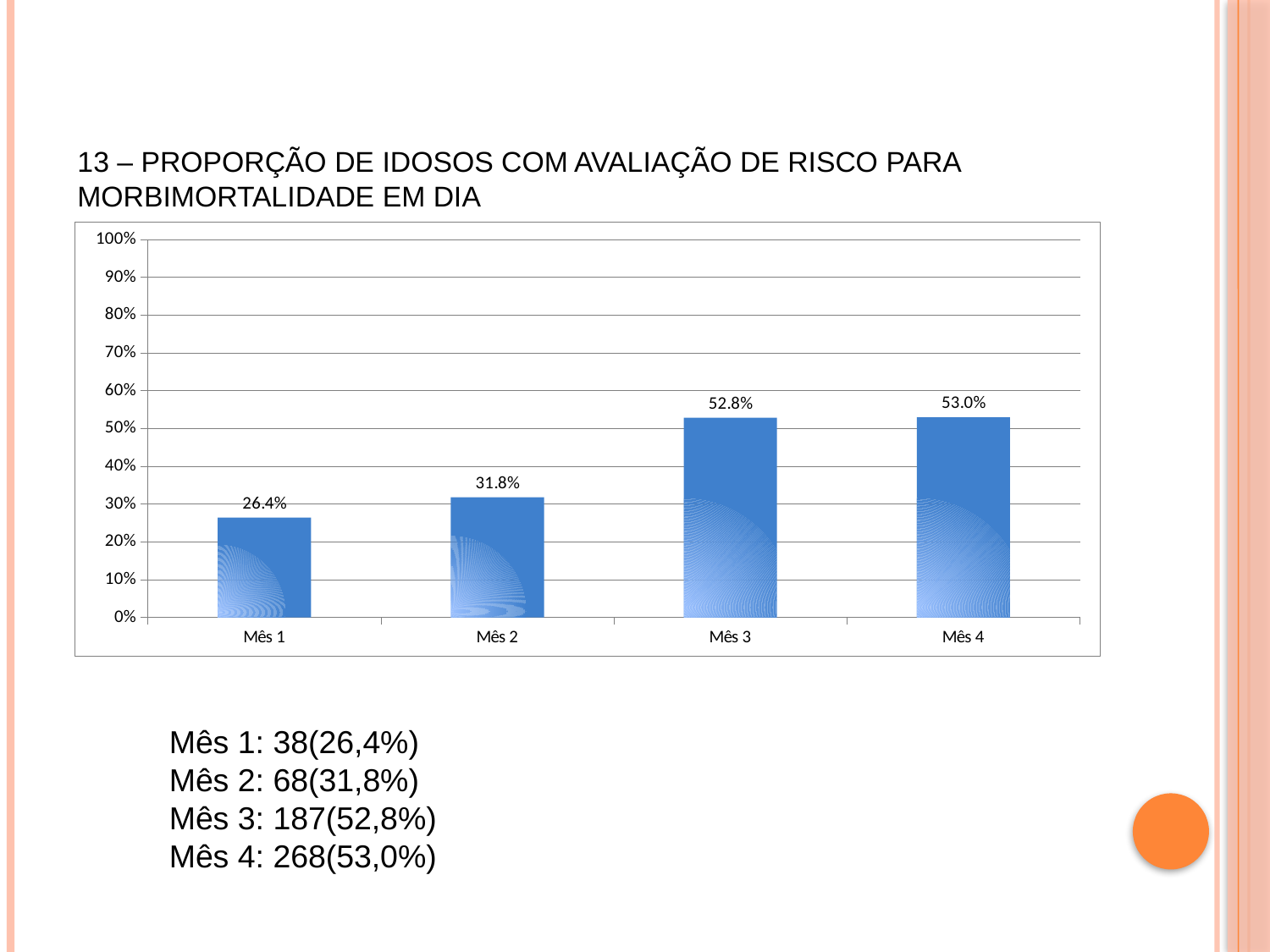
What is the value for Mês 1? 26.4% What is the value for Mês 3? 52.8% Which is larger, the value for Mês 2 or the value for Mês 3? Mês 3 Which month has the lowest value? Mês 1 Is the value for Mês 4 greater or less than 50%? greater How many months are shown on the x axis? 4 What kind of chart is shown on the slide? bar chart Do the values rise or fall from Mês 1 to Mês 4? rise What is the value for Mês 2? 31.8% What is the value for Mês 4? 53.0% What is the difference between the values for Mês 2 and Mês 1? 5.4% What is the difference between the values for Mês 3 and Mês 2? 21.0%